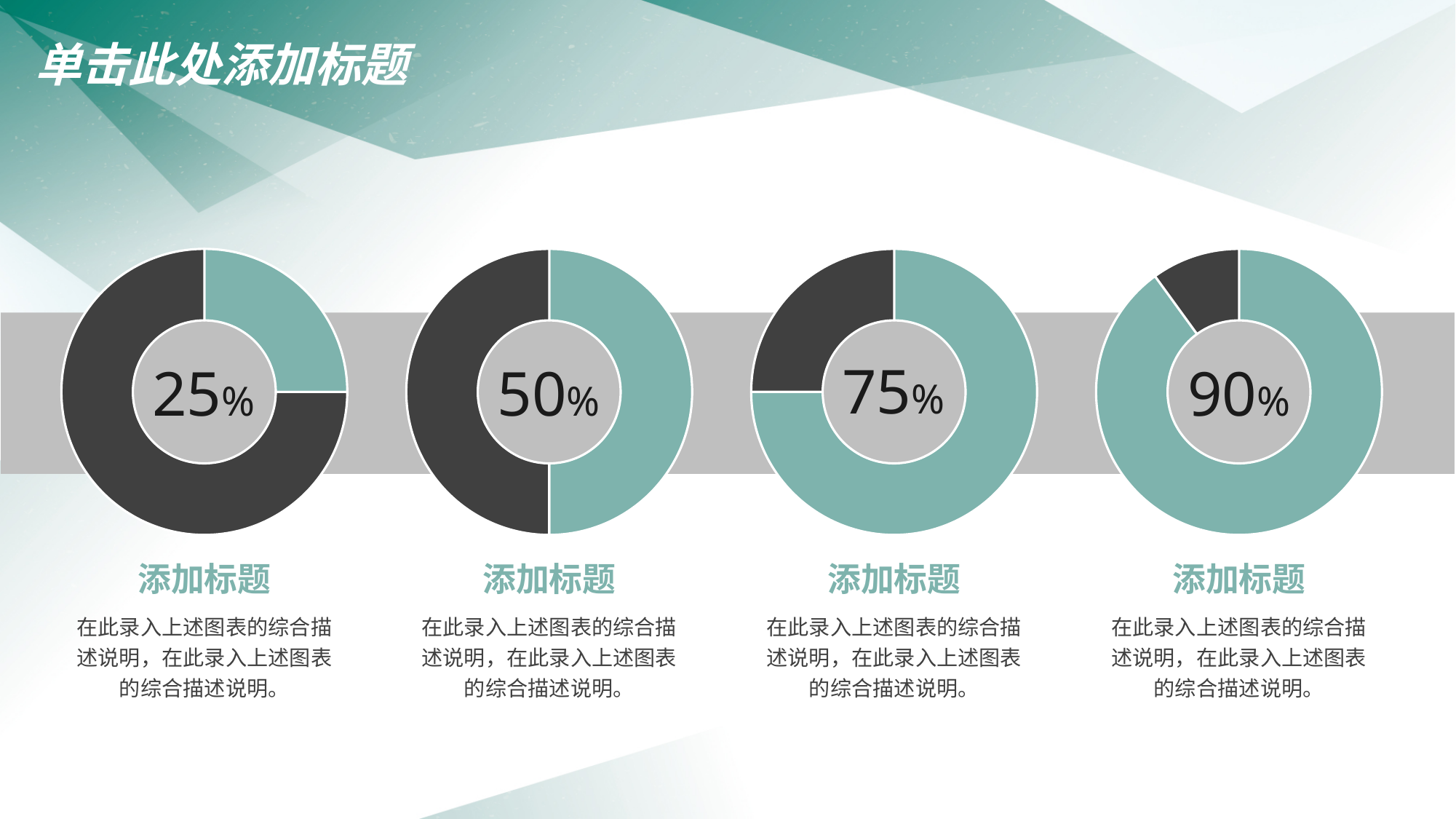
How many donut charts are on the slide? 4 Which donut chart shows the highest percentage? The rightmost one (90%) What percentage is shown in the centre of the third donut chart from the left? 75% What is the difference between the percentage in the rightmost donut chart and the percentage in the leftmost donut chart? 65% What percentage is shown in the centre of the second donut chart from the left? 50% What is the difference between the percentages shown in the third and second donut charts from the left? 25% What percentage is shown in the centre of the leftmost donut chart? 25% What kind of chart is used to display the percentages on the slide? Donut chart Do the percentages in the donut charts increase or decrease from left to right across the slide? Increase What percentage is shown in the centre of the rightmost donut chart? 90% Which donut chart shows the lowest percentage? The leftmost one (25%) Which is larger, the percentage in the second donut chart from the left or the percentage in the third donut chart from the left? The third (75%)